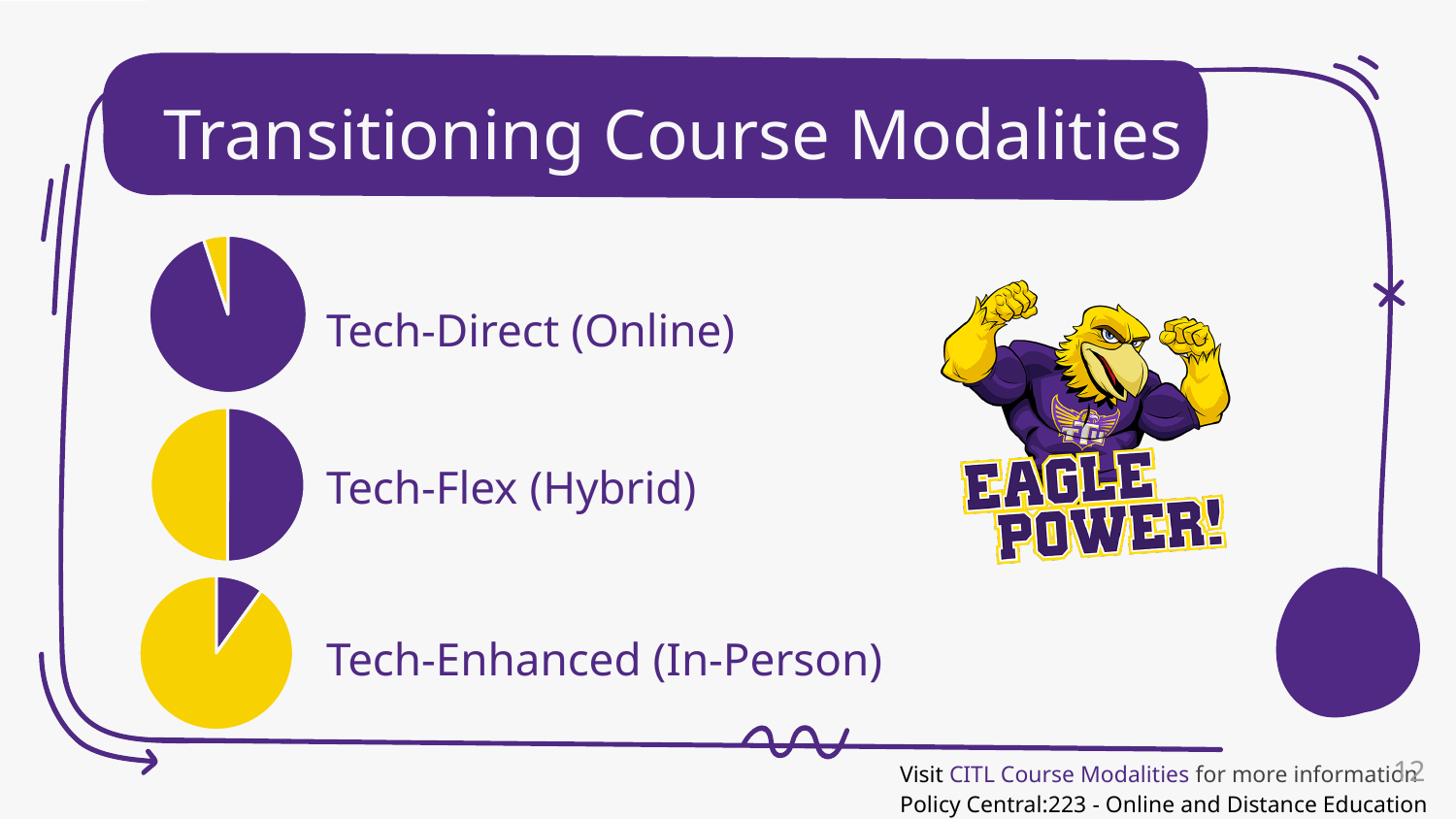
Which of the three pie charts has the largest purple slice? Tech-Direct (Online) Which of the three pie charts has the smallest yellow slice? Tech-Direct (Online) What is the title of the slide containing the pie charts? Transitioning Course Modalities What label appears next to the middle pie chart? Tech-Flex (Hybrid) Which of the three pie charts has the largest yellow slice? Tech-Enhanced (In-Person) In the pie chart next to Tech-Direct (Online), which slice is larger, the purple one or the yellow one? purple How many pie charts are shown on the slide? 3 What kind of chart is shown next to the label Tech-Direct (Online)? pie chart In the pie chart next to Tech-Enhanced (In-Person), which slice is larger, the purple one or the yellow one? yellow